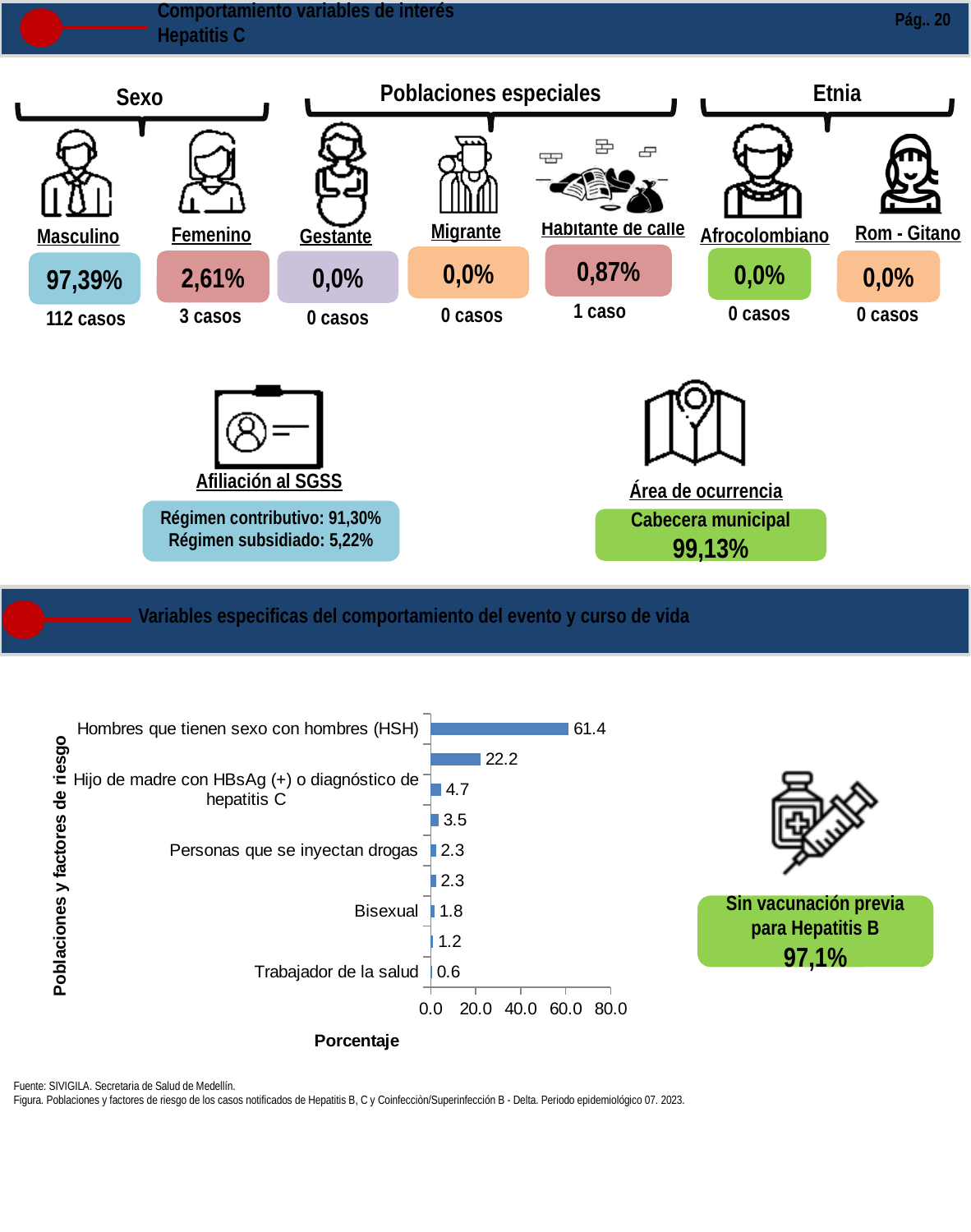
In the bar chart, which is larger: the value for Personas que se inyectan drogas or the value for Trabajador de la salud? Personas que se inyectan drogas What is the x-axis title of the bar chart? Porcentaje In the bar chart, what is the value for Bisexual? 1.8 In the bar chart, which category has the highest value? Hombres que tienen sexo con hombres (HSH) How many bars are plotted in the bar chart? 9 In the bar chart, what is the value for Hombres que tienen sexo con hombres (HSH)? 61.4 What type of chart is shown at the bottom of the slide? bar chart In the bar chart, which category has the lowest value? Trabajador de la salud In the bar chart, what is the difference between the values for Hombres que tienen sexo con hombres (HSH) and Bisexual? 59.6 In the bar chart, what is the value for Trabajador de la salud? 0.6 In the bar chart, what is the value for Hijo de madre con HBsAg (+) o diagnóstico de hepatitis C? 4.7 In the bar chart, what is the value for Personas que se inyectan drogas? 2.3